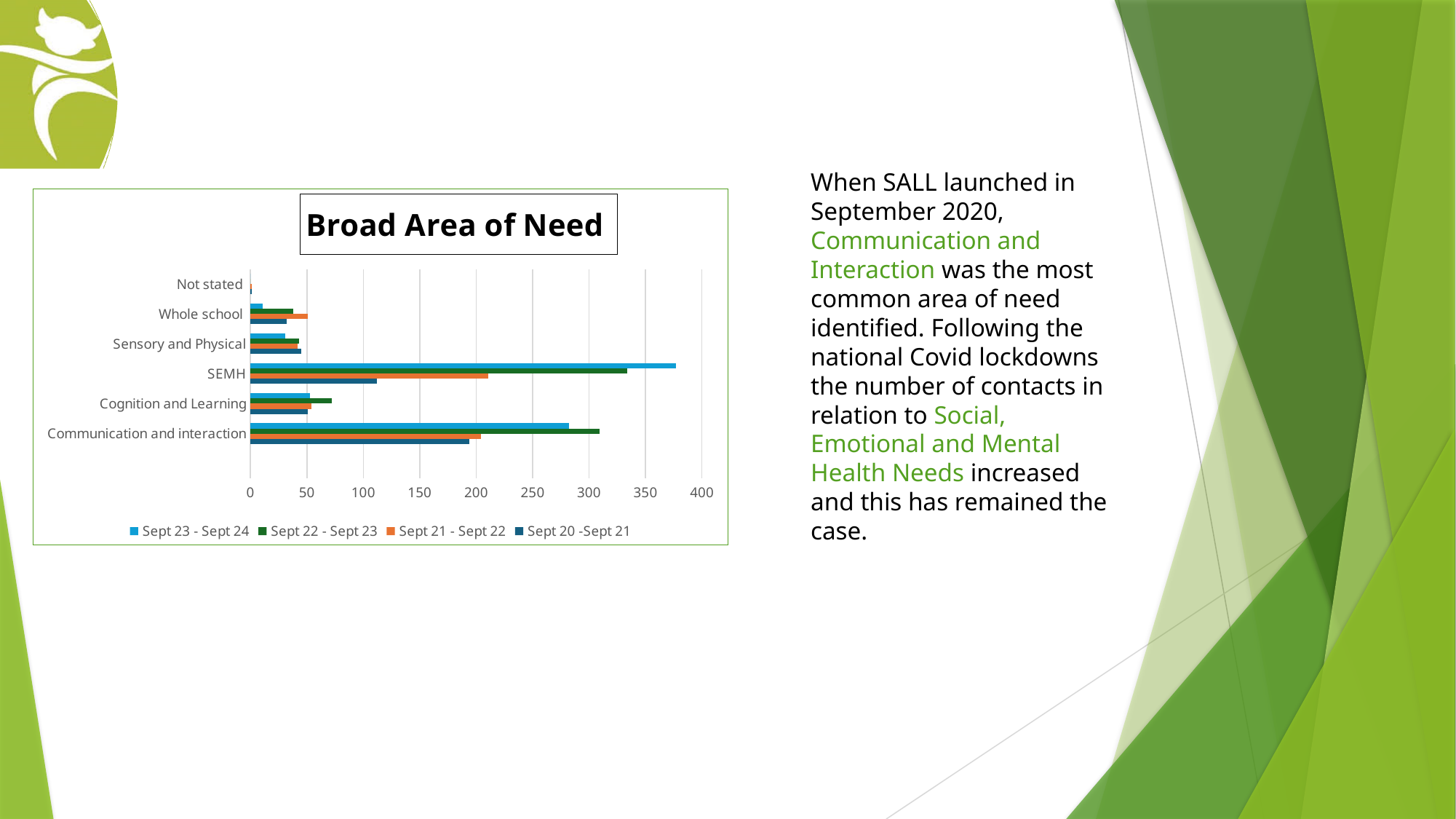
How many series does the legend of the "Broad Area of Need" chart list? 4 For Communication and interaction, which series has the larger value: Sept 22 - Sept 23 or Sept 23 - Sept 24? Sept 22 - Sept 23 For SEMH, which series has the larger value: Sept 21 - Sept 22 or Sept 20 -Sept 21? Sept 21 - Sept 22 Which category has the highest value for the Sept 23 - Sept 24 series? SEMH What is the title of the chart on the slide? Broad Area of Need Is the value for Communication and interaction in the Sept 21 - Sept 22 series greater or less than 250? less Is the value for SEMH in the Sept 23 - Sept 24 series greater or less than 350? greater What kind of chart is shown under the title "Broad Area of Need"? bar chart Which category has the highest value for the Sept 20 -Sept 21 series? Communication and interaction Is the value for SEMH in the Sept 20 -Sept 21 series greater or less than 150? less Which series is shown in light blue in the "Broad Area of Need" chart? Sept 23 - Sept 24 How many categories are shown on the vertical axis of the "Broad Area of Need" chart? 6